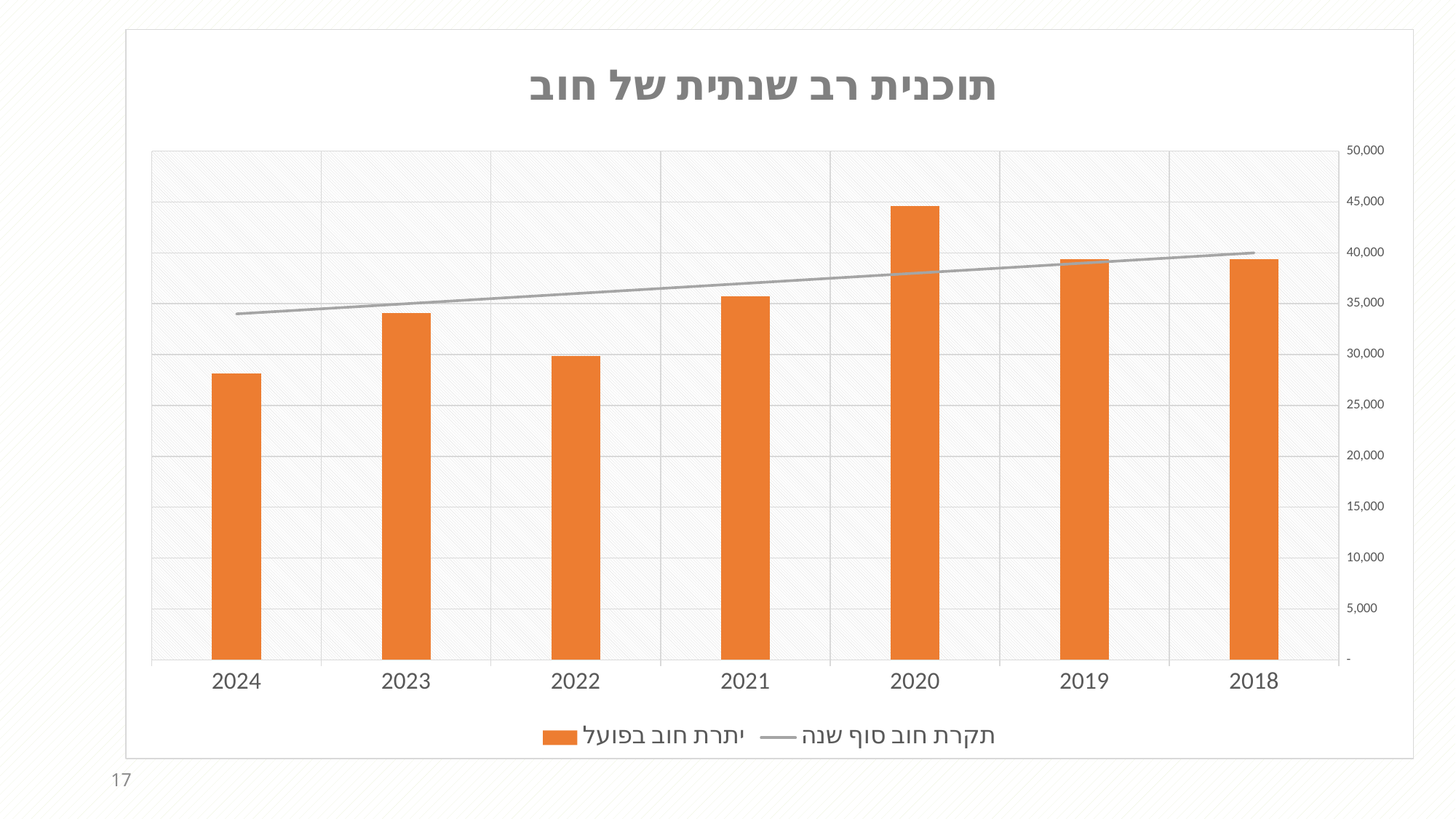
Which is larger, the יתרת חוב בפועל bar for 2024 or for 2023? 2023 Is the value of יתרת חוב בפועל for 2023 greater or less than 35,000? less Which is larger, the יתרת חוב בפועל bar for 2020 or for 2021? 2020 How many years are shown on the x axis? 7 Is the value of יתרת חוב בפועל for 2024 greater or less than 30,000? less What is the title of the chart? תוכנית רב שנתית של חוב How many series does the legend list? 2 Does the תקרת חוב סוף שנה line rise or fall moving from left (2024) to right (2018) along the x axis? rise Is the value of יתרת חוב בפועל for 2020 greater or less than 40,000? greater What kind of chart is this? A bar chart combined with a line Which year has the highest bar for יתרת חוב בפועל? 2020 Which year has the lowest bar for יתרת חוב בפועל? 2024